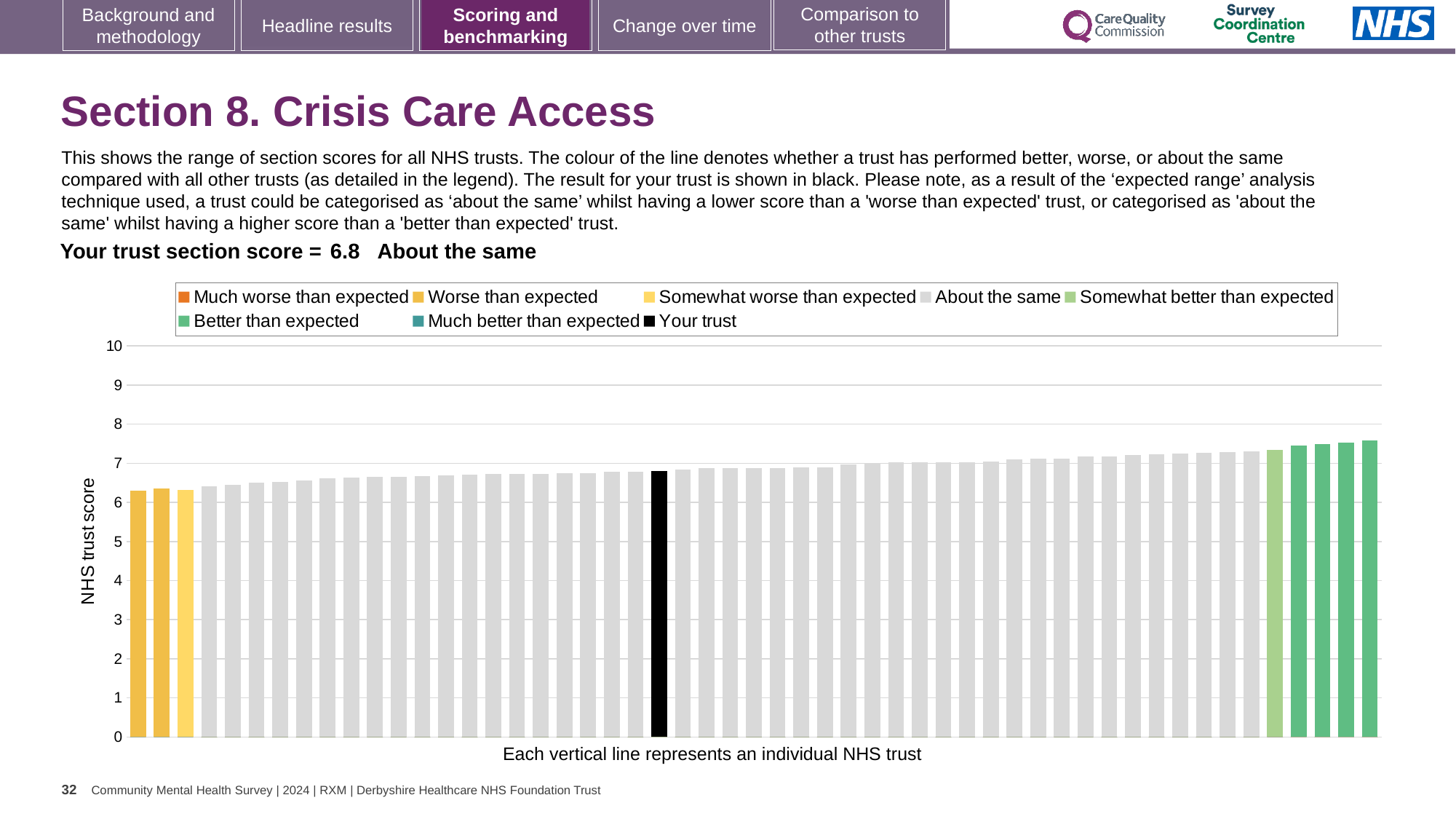
Is the value of the shortest bar greater or less than 6? greater Is the value for your trust (the black bar) greater or less than 5? greater Is the value of the tallest bar greater or less than 8? less Do the bar values rise or fall from left to right along the x axis? rise What kind of chart is shown on the slide? bar chart How many entries does the chart legend list? 8 What is the label on the vertical axis of the chart? NHS trust score How many bars are coloured as 'Better than expected'? 4 How many bars are coloured as 'Worse than expected'? 2 What is the section score for your trust shown on the slide? 6.8 Which performance category is your trust placed in according to the slide? About the same